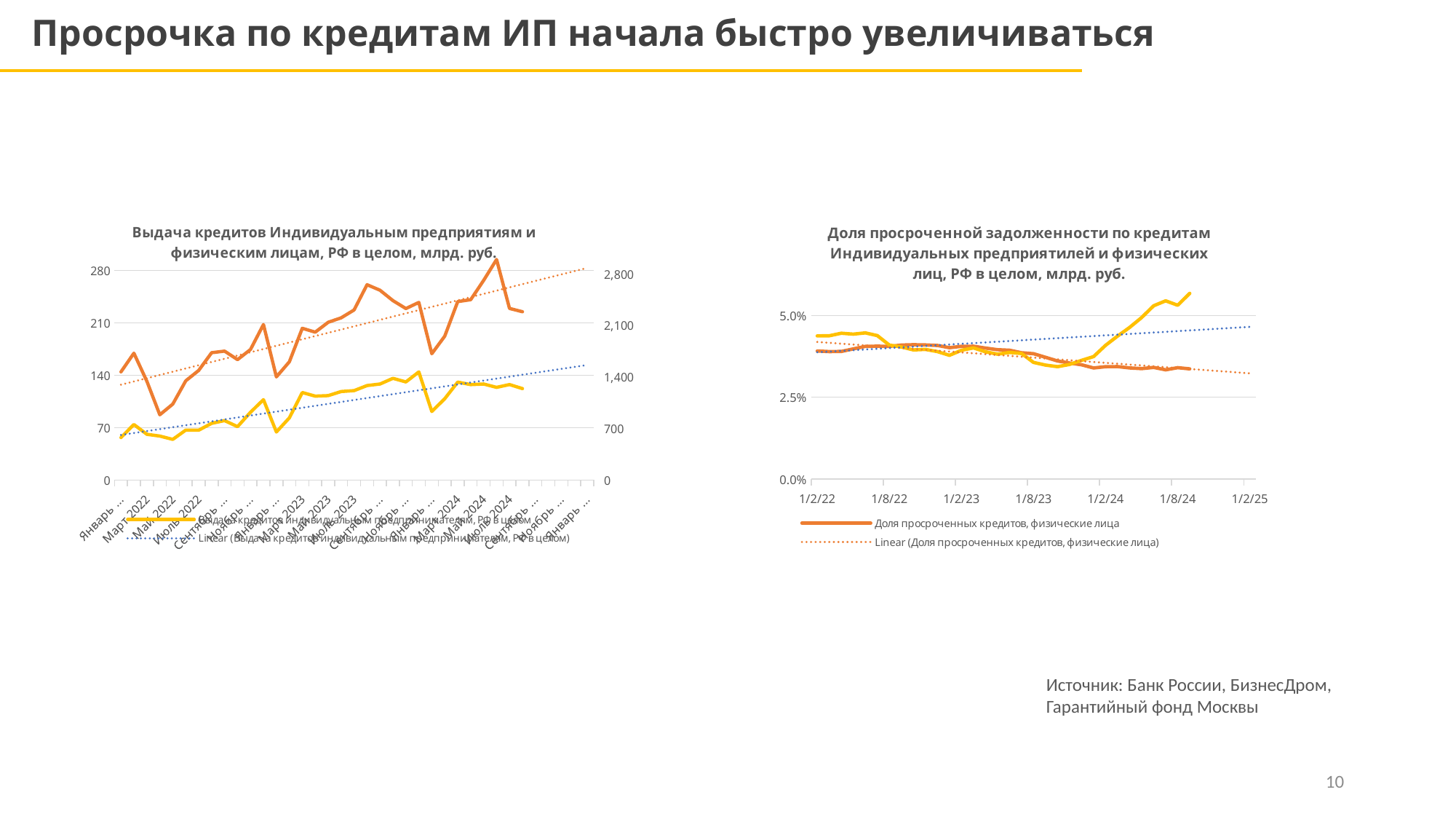
What kind of chart is the right chart, "Доля просроченной задолженности по кредитам Индивидуальных предприятилей и физических лиц, РФ в целом, млрд. руб."? line chart In the right chart, is the value of the orange line at 1/2/22 greater or less than 2.5%? greater In the right chart, at the last plotted point, which line is higher: the yellow line or the orange line? the yellow line In the left chart, does the orange line rise or fall overall from the first to the last point? rise How many entries does the legend of the right chart list? 2 In the left chart, does the yellow line rise or fall overall from the first to the last point? rise In the right chart, does the yellow line rise or fall overall from 1/2/22 to its last point? rise What kind of chart is the left chart, "Выдача кредитов Индивидуальным предприятиям и физическим лицам, РФ в целом, млрд. руб."? line chart In the right chart, is the last value of the orange line "Доля просроченных кредитов, физические лица" greater or less than 5.0%? less What is the highest tick label on the vertical axis of the right chart? 5.0% In the right chart, is the last value of the yellow line greater or less than 5.0%? greater